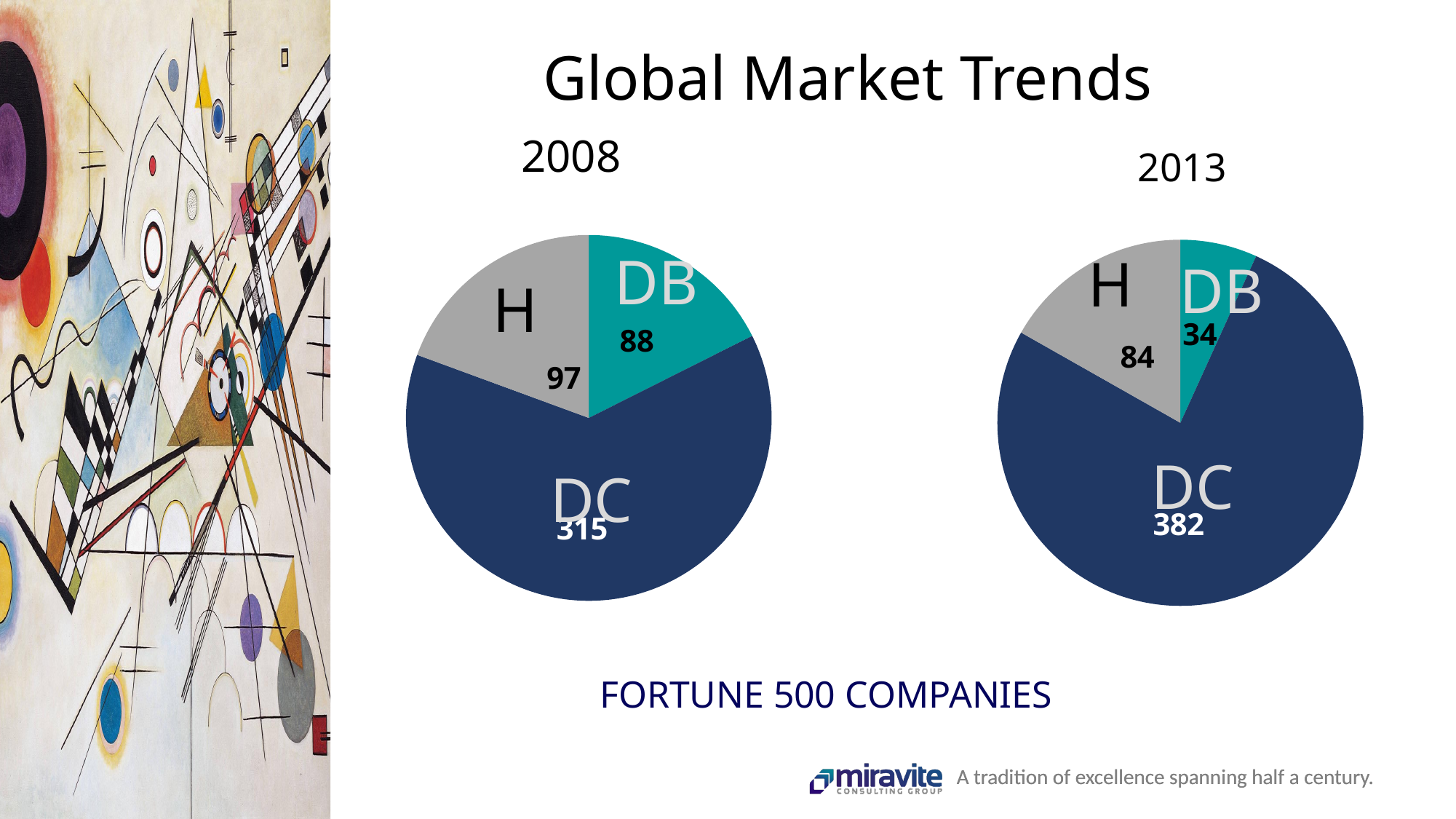
What type of chart is used to show the 2008 data? Pie chart In the 2008 pie chart, what is the difference between the H value and the DB value? 9 In the 2008 pie chart, what is the value for H? 97 Is the H value larger in the 2008 pie chart or the 2013 pie chart? 2008 In the 2013 pie chart, which category has the largest slice? DC How many slices does the 2013 pie chart have? 3 In the 2008 pie chart, what share of the total does DC represent? 63% In the 2008 pie chart, which category has the smallest slice? DB What is the difference between the DC value in the 2013 pie chart and the DC value in the 2008 pie chart? 67 In the 2008 pie chart, what is the value for DC? 315 In the 2013 pie chart, which category has the smallest slice? DB In the 2013 pie chart, what is the value for DB? 34